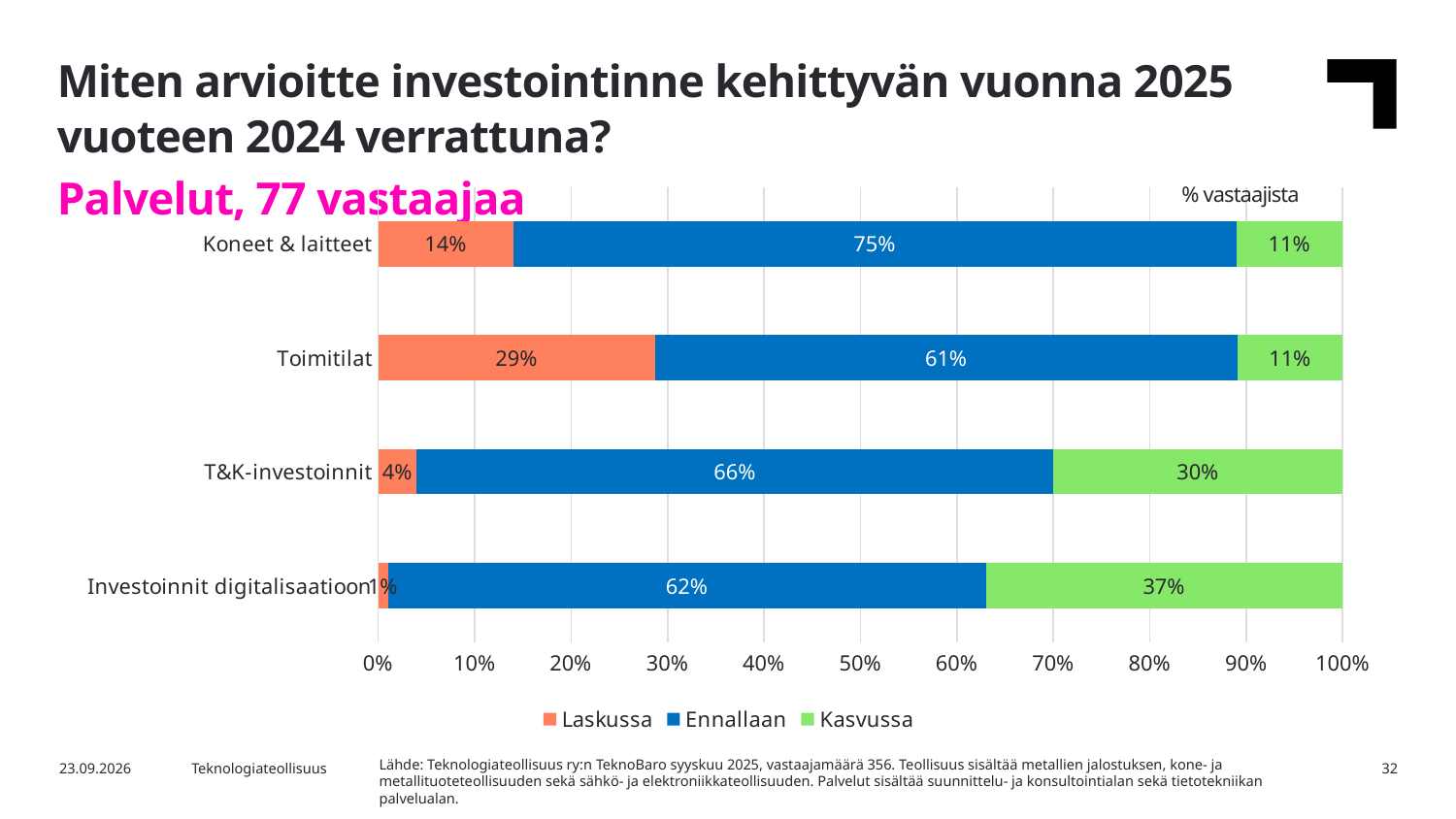
What is the Kasvussa value for Investoinnit digitalisaatioon? 37% How many series does the legend list? 3 Which category has the lowest Laskussa share? Investoinnit digitalisaatioon What kind of chart is shown on the slide? Stacked bar chart What percentage of respondents expect Koneet & laitteet investments to be Ennallaan? 75% How many categories are shown on the chart? 4 What is the difference between the Laskussa values for Toimitilat and Koneet & laitteet? 15% What is the subtitle of the chart shown in pink? Palvelut, 77 vastaajaa What is the Laskussa value for Toimitilat? 29% What is the Kasvussa value for T&K-investoinnit? 30% Which category has the highest Kasvussa share? Investoinnit digitalisaatioon Which is larger: the Ennallaan value for Koneet & laitteet or for T&K-investoinnit? Koneet & laitteet